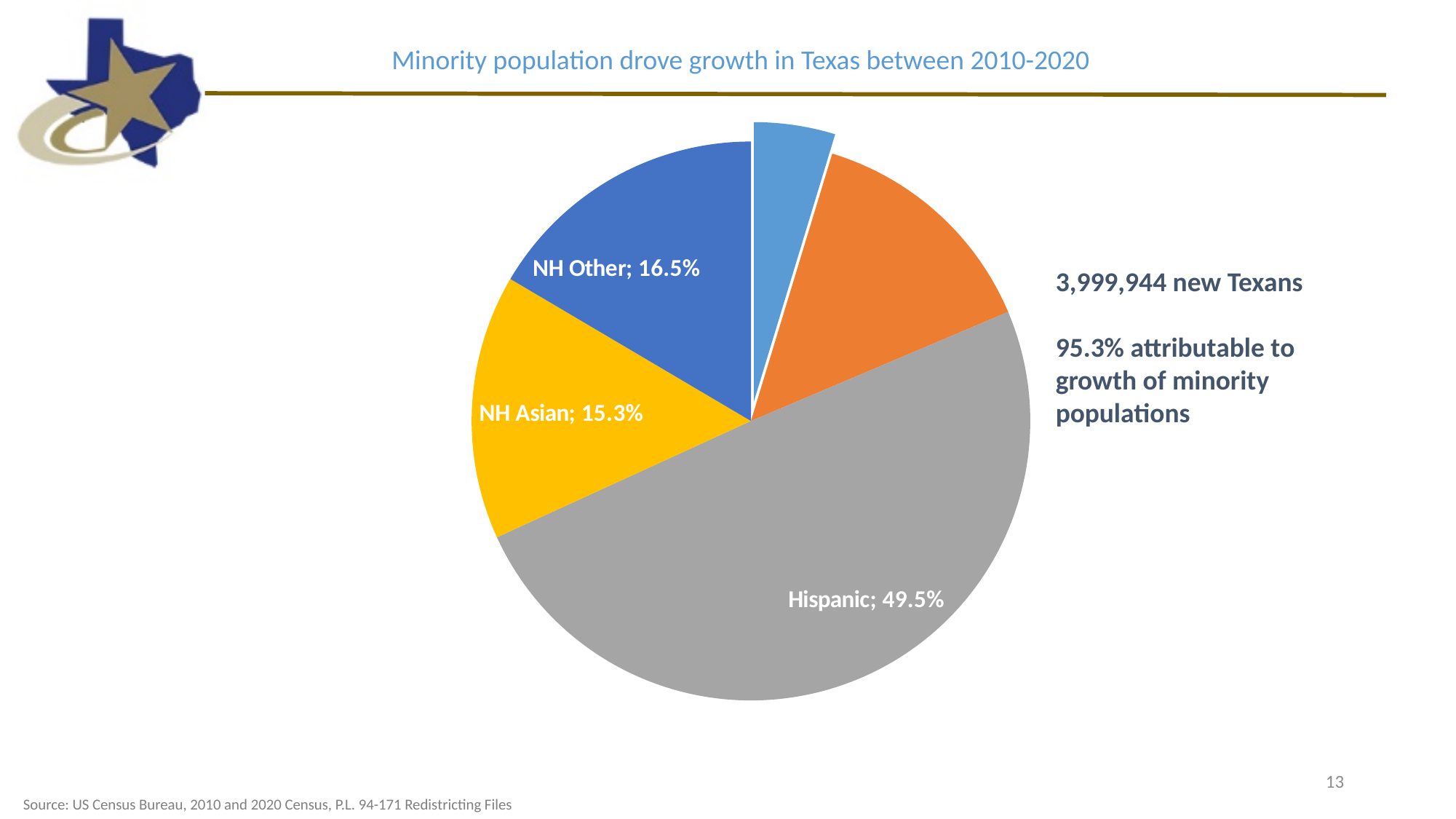
What kind of chart is shown on the slide? Pie chart How many slices does the pie chart have? 5 How many slices of the pie have a printed data label? 3 What colour is the Hispanic slice of the pie? Grey What share of the pie does the Hispanic slice represent? 49.5% What is the title of the slide containing the chart? Minority population drove growth in Texas between 2010-2020 What is the value shown for NH Other? 16.5% What is the difference in percentage points between NH Other and NH Asian? 1.2 Which of the labeled categories has the smallest slice? NH Asian Which is larger, the NH Other slice or the NH Asian slice? NH Other Which labeled category has the largest slice of the pie? Hispanic What is the value shown for NH Asian? 15.3%